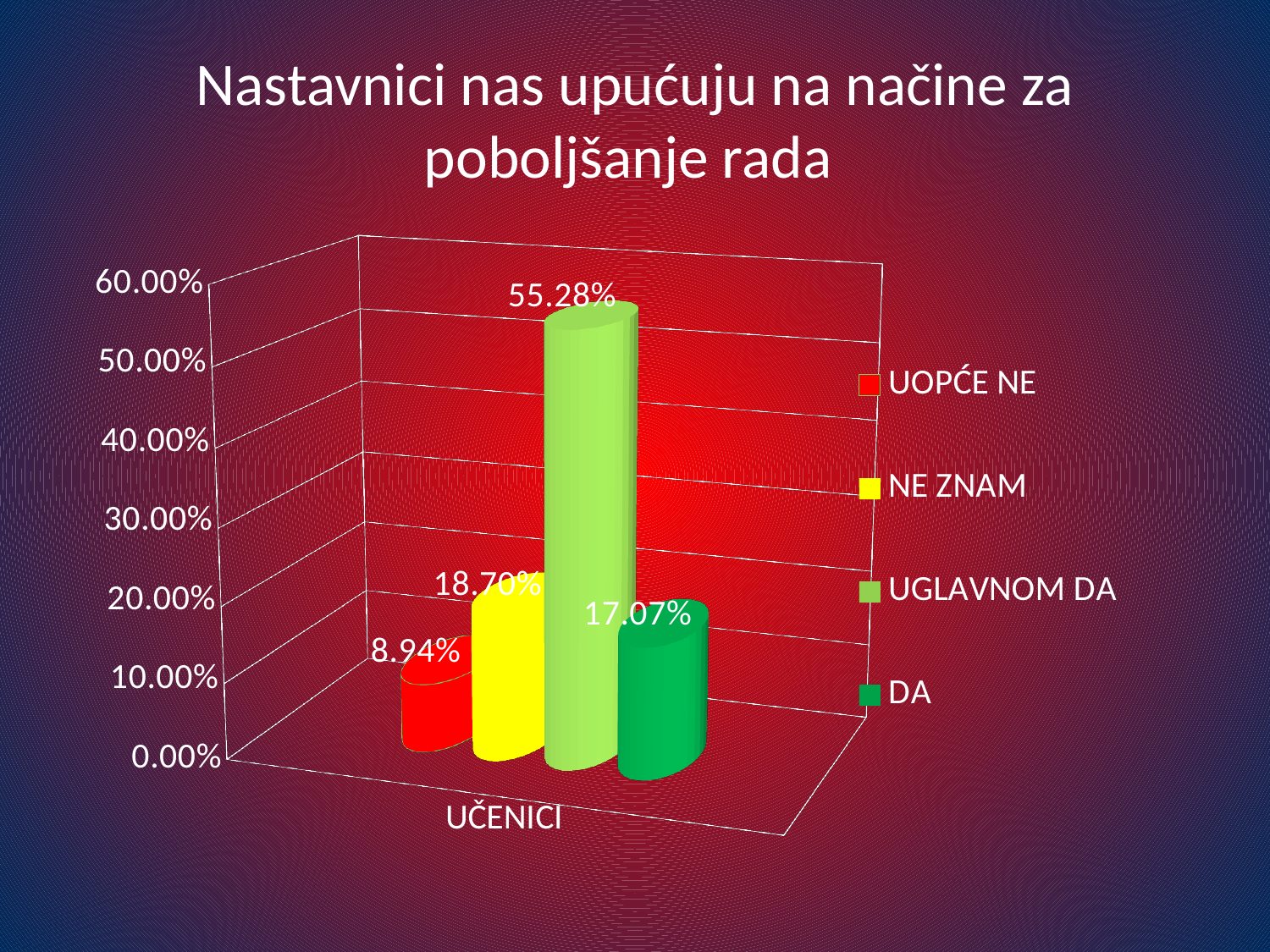
Which series has the highest value? UGLAVNOM DA What kind of chart is shown on the slide? bar chart What is the difference between the values for UGLAVNOM DA and NE ZNAM? 36.58% What is the value for NE ZNAM? 18.70% Which is larger, the value for NE ZNAM or the value for DA? NE ZNAM Is the value for UGLAVNOM DA greater or less than 50.00%? greater What is the value for UGLAVNOM DA? 55.28% What is the category label shown on the x axis? UČENICI Which series has the lowest value? UOPĆE NE What is the value for UOPĆE NE? 8.94% What is the value for DA? 17.07% How many series does the legend list? 4